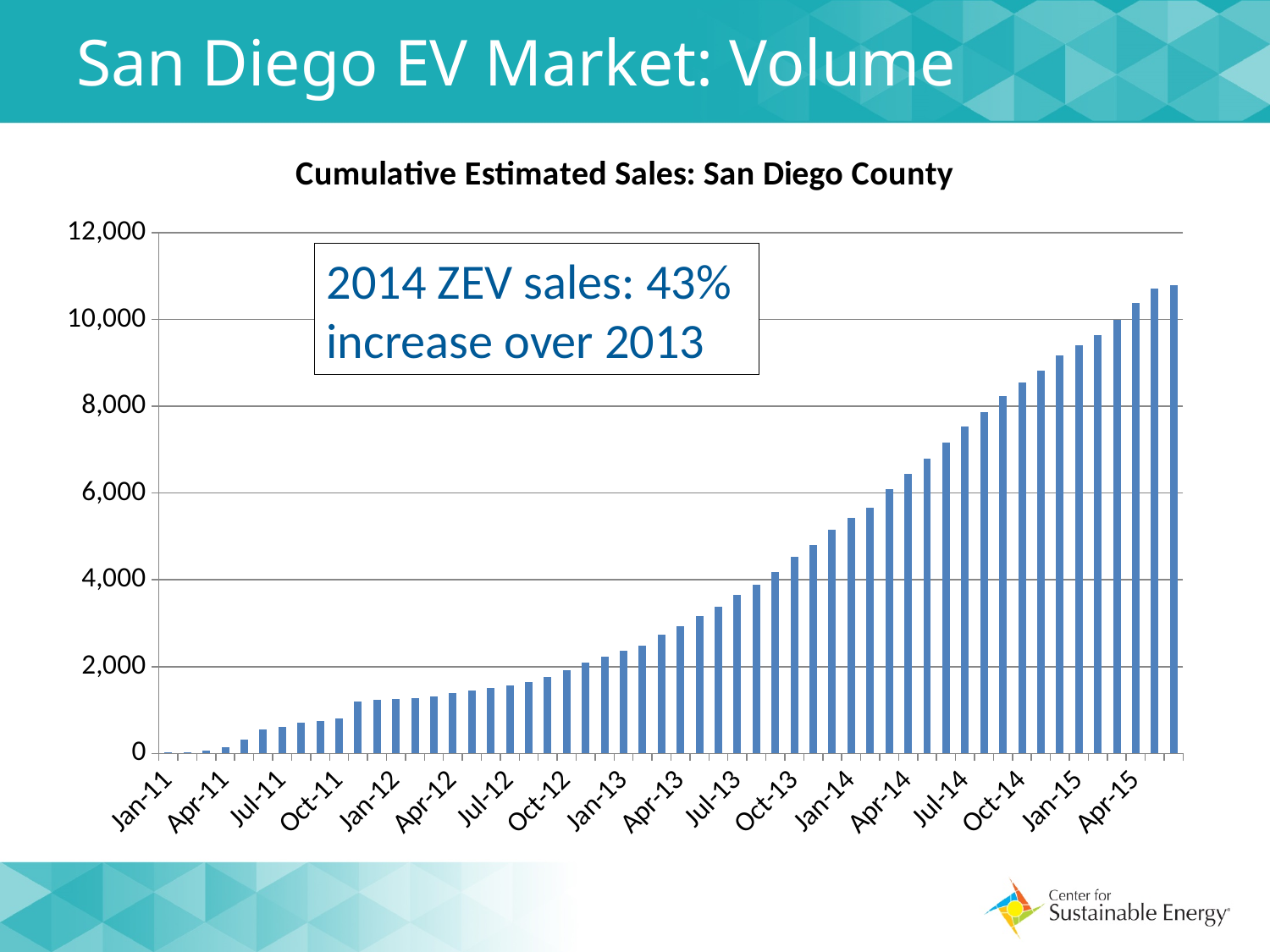
Which is larger, the value for Jan-13 or the value for Jan-14? Jan-14 Is the value for Jul-14 greater or less than 8,000? less Is the value for Jul-13 greater or less than 4,000? less Is the value for Jan-12 greater or less than 2,000? less What is the title of the chart? Cumulative Estimated Sales: San Diego County Which labeled month has the highest cumulative sales? Apr-15 Which labeled month has the lowest cumulative sales? Jan-11 Do the values rise or fall from Jan-11 to Apr-15? rise According to the text box on the chart, by what percentage did 2014 ZEV sales increase over 2013? 43% What kind of chart is shown on the slide? bar chart